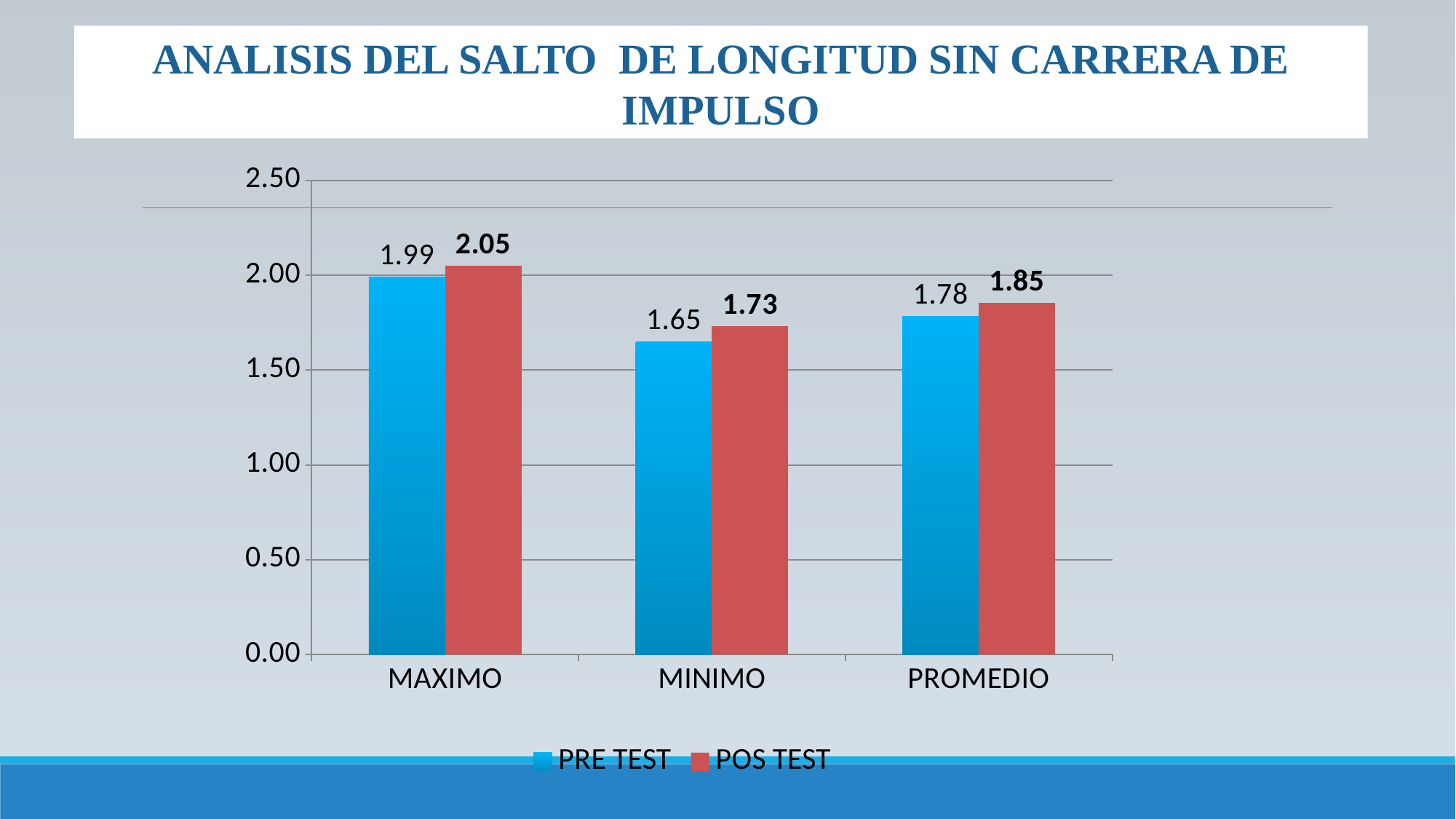
What kind of chart is shown on the slide? bar chart What is the POS TEST value for MINIMO? 1.73 How many categories are shown on the x axis? 3 What is the PRE TEST value for MAXIMO? 1.99 What is the difference between the POS TEST and PRE TEST values for MINIMO? 0.08 Which category has the lowest PRE TEST value? MINIMO What is the POS TEST value for PROMEDIO? 1.85 Which is larger for PROMEDIO, the PRE TEST value or the POS TEST value? POS TEST What is the difference between the POS TEST and PRE TEST values for MAXIMO? 0.06 Which category has the highest POS TEST value? MAXIMO Is the PRE TEST value for MINIMO greater or less than 2.00? less How many series does the legend list? 2